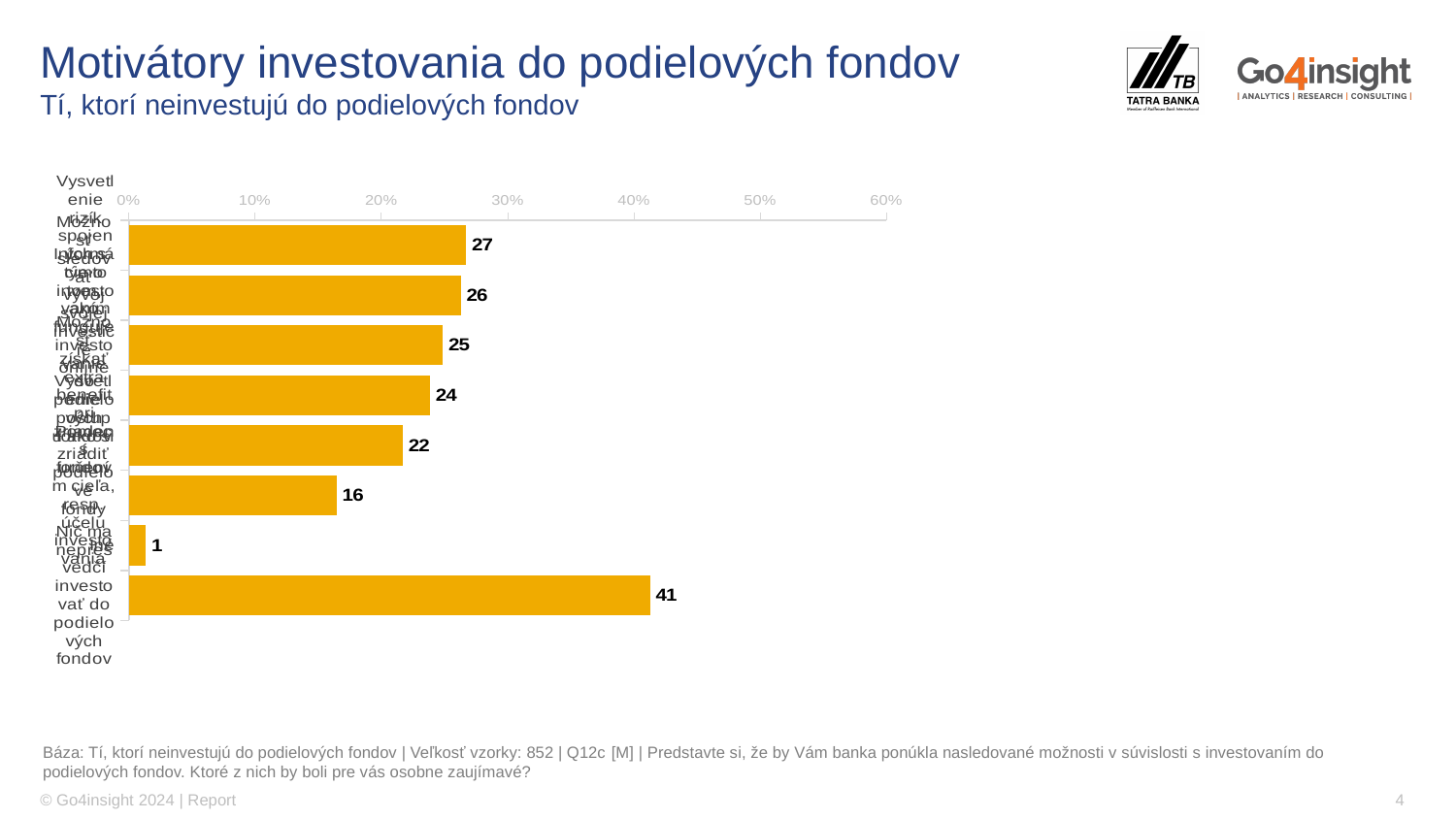
What is the value of the second bar from the top? 26 What is the difference between the bottom bar (41) and the top bar (27)? 14 What is the value of the sixth bar from the top? 16 What is the value of the topmost bar in the chart? 27 What is the highest value shown in the chart? 41 What is the lowest value shown in the chart? 1 What is the difference between the highest value and the lowest value in the chart? 40 What kind of chart is shown on the slide? Bar chart How many bars are plotted in the chart? 8 What is the maximum value shown on the horizontal axis? 60% Which is larger: the value of the topmost bar or the value of the bottom bar? The bottom bar Is the value of the bottom bar greater or less than 40%? greater